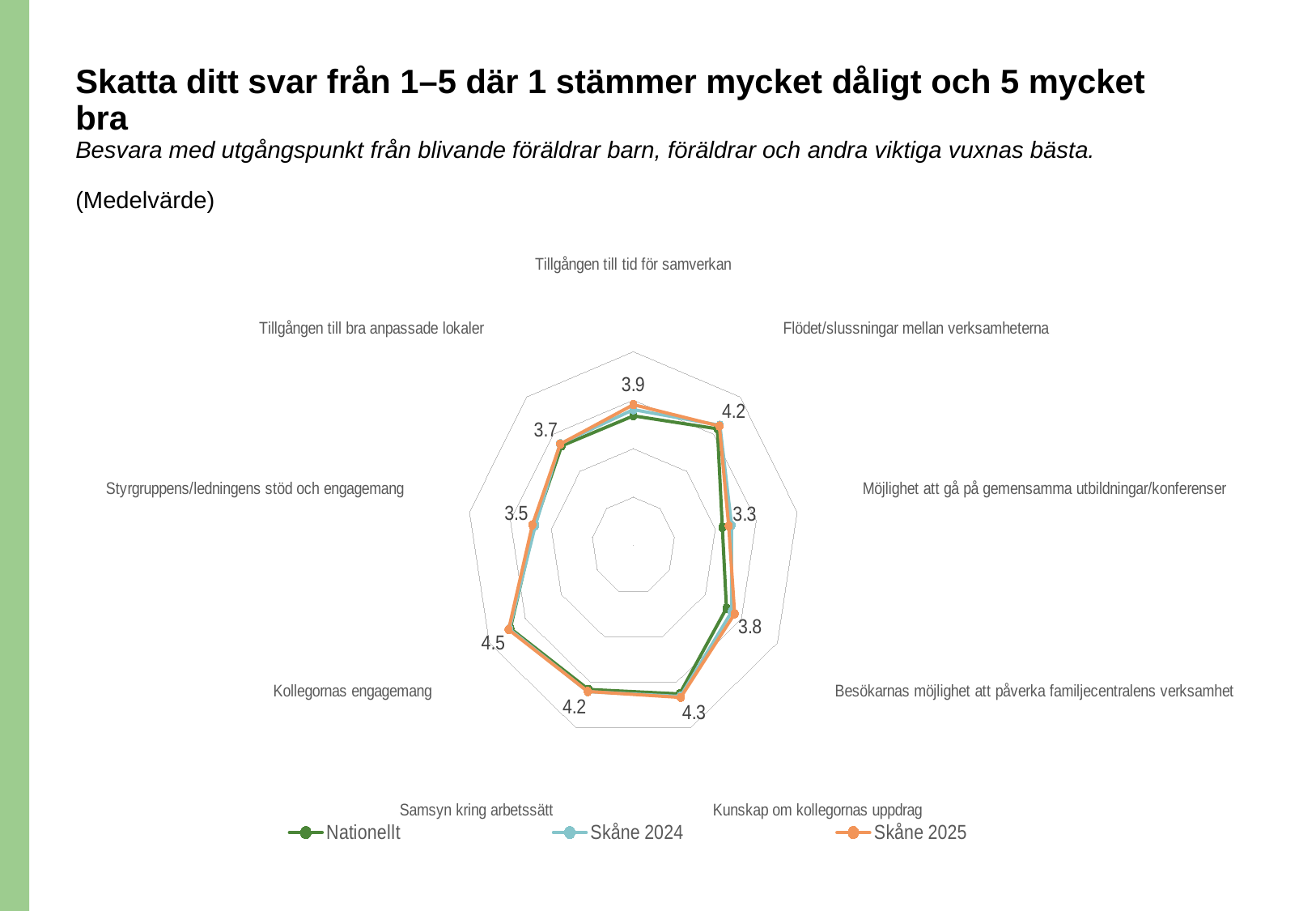
Which series is drawn in orange in the legend? Skåne 2025 What is the labelled value for Skåne 2025 on 'Kunskap om kollegornas uppdrag'? 4.3 How many categories (axes) does the radar chart have? 9 What is the labelled value for Skåne 2025 on 'Möjlighet att gå på gemensamma utbildningar/konferenser'? 3.3 What is the difference between the Skåne 2025 labelled values for 'Kollegornas engagemang' and 'Styrgruppens/ledningens stöd och engagemang'? 1.0 Which has the larger Skåne 2025 labelled value: 'Flödet/slussningar mellan verksamheterna' or 'Tillgången till bra anpassade lokaler'? Flödet/slussningar mellan verksamheterna What is the labelled value for Skåne 2025 on 'Kollegornas engagemang'? 4.5 Which category has the lowest labelled value for Skåne 2025? Möjlighet att gå på gemensamma utbildningar/konferenser How many series does the legend list? 3 What kind of chart is shown on the slide? Radar chart Which category has the highest labelled value for Skåne 2025? Kollegornas engagemang What is the labelled value for Skåne 2025 on 'Tillgången till tid för samverkan'? 3.9